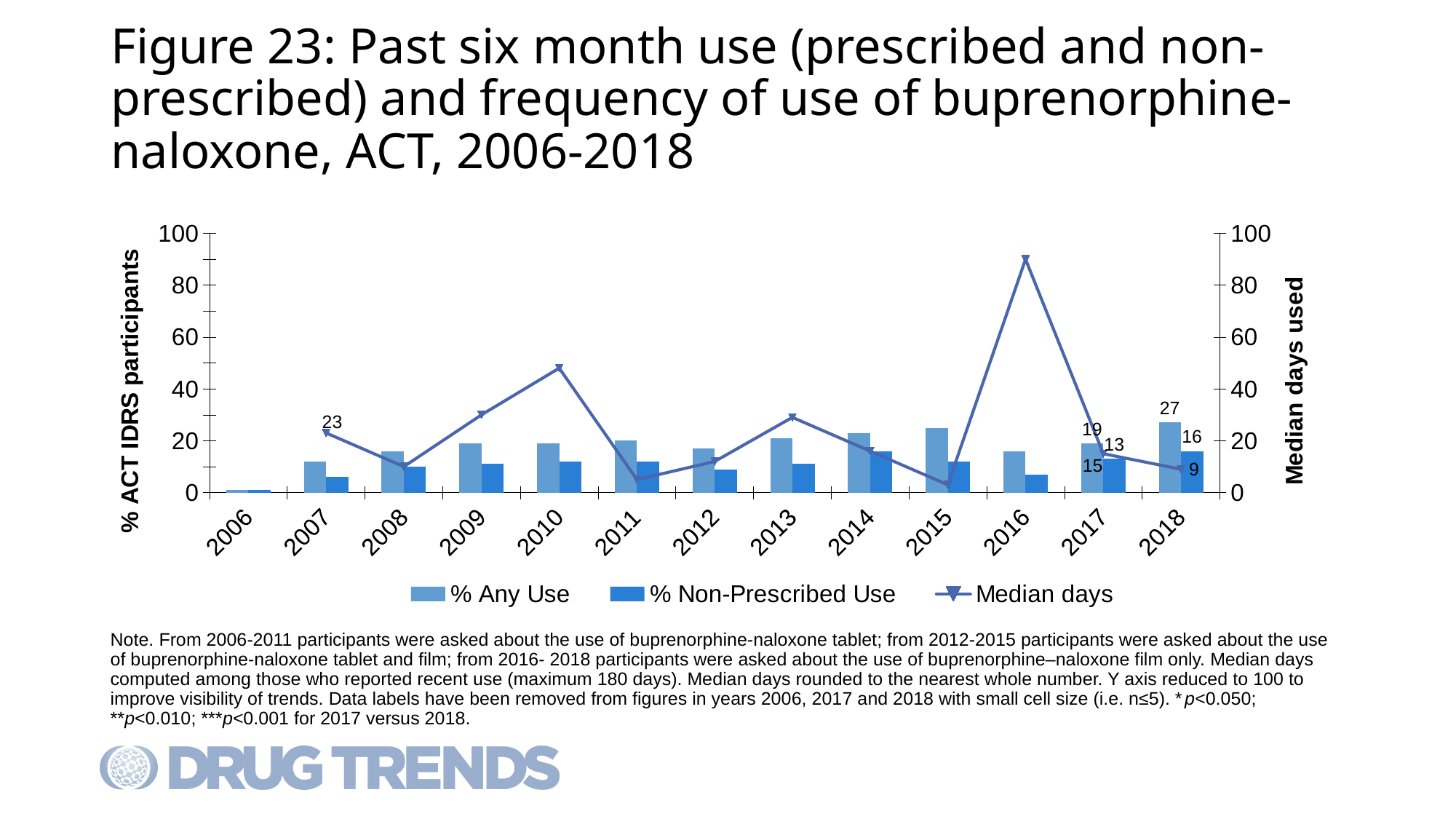
In which year is the median days used highest? 2016 What is the difference between % Any Use and % Non-Prescribed Use in 2018? 11 What is the median days used value for 2007? 23 What is the % Any Use value for 2018? 27 How many series does the legend list? 3 What is the median days used value for 2018? 9 Is the median days used value for 2016 greater or less than 80? greater What is the difference in median days used between 2017 and 2018? 6 What is the title of the right-hand vertical axis? Median days used What is the % Non-Prescribed Use value for 2017? 13 How many years are shown on the x axis? 13 Which year has the larger % Any Use value, 2017 or 2018? 2018